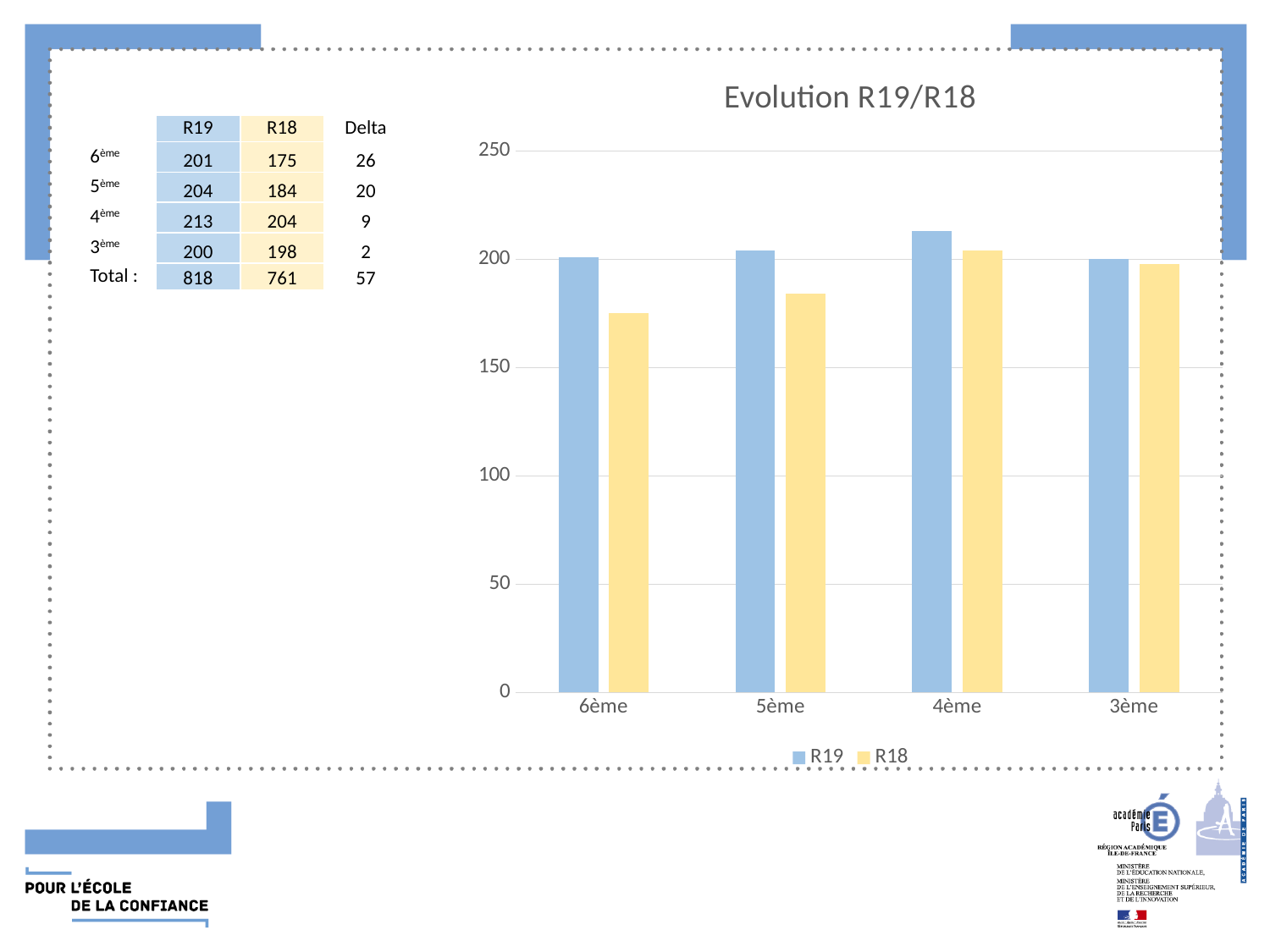
For 6ème, which is larger, R19 or R18? R19 What is the difference between R19 and R18 for 6ème? 26 Which category has the lowest R18 value? 6ème How many series does the chart legend list? 2 What kind of chart is shown on the slide? bar chart Which category has the highest R19 value? 4ème What is the title of the chart? Evolution R19/R18 Is the R18 value for 6ème greater or less than 200? less What is the R19 value for 6ème? 201 Does the R18 value rise or fall from 6ème to 5ème? rise How many categories are shown on the x axis of the chart? 4 What is the R18 value for 5ème? 184